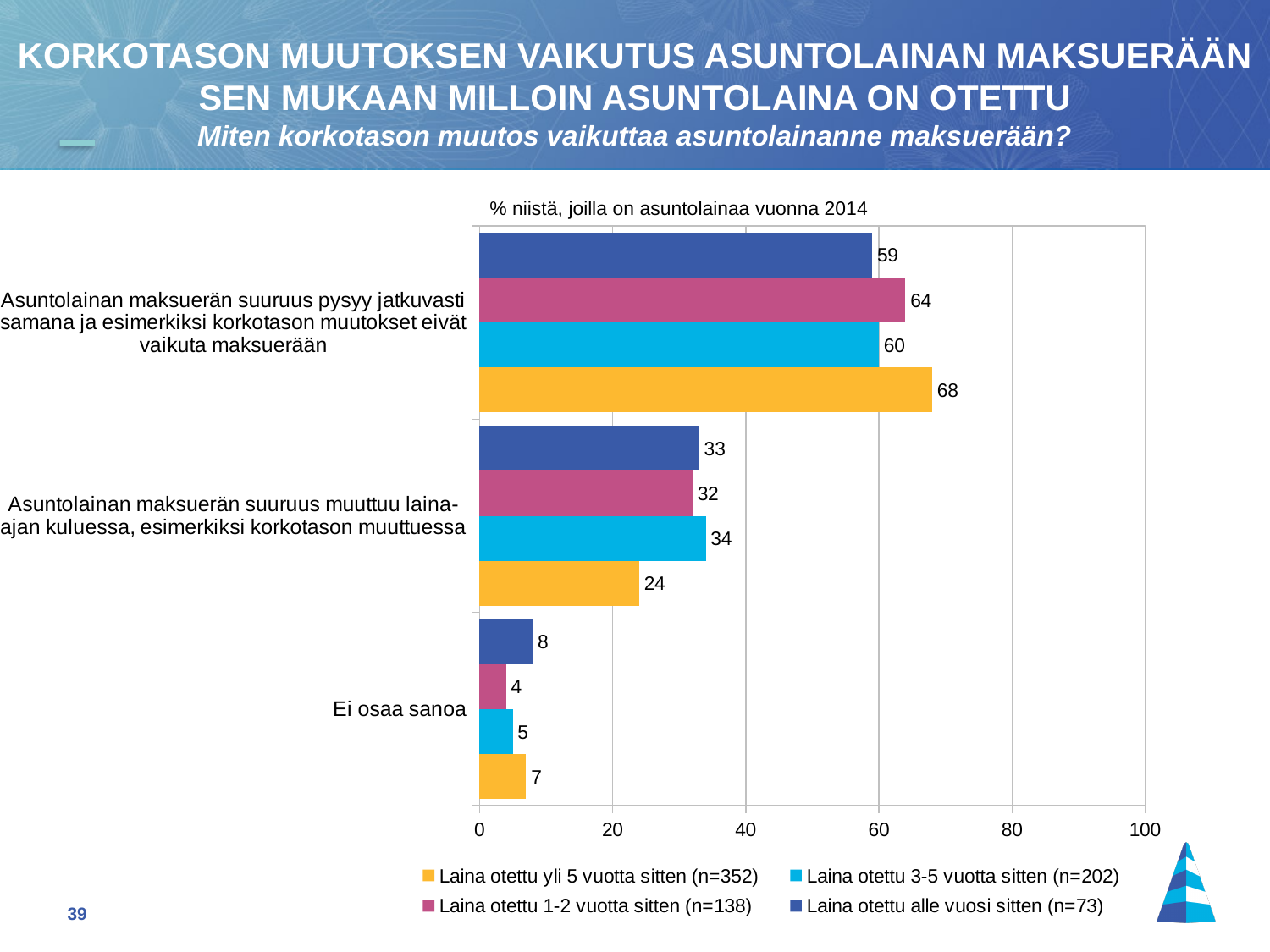
Is the value for 'Laina otettu yli 5 vuotta sitten (n=352)' in the category 'Asuntolainan maksuerän suuruus muuttuu laina-ajan kuluessa, esimerkiksi korkotason muuttuessa' greater or less than 40? less What is the value for 'Laina otettu yli 5 vuotta sitten (n=352)' in the category 'Asuntolainan maksuerän suuruus pysyy jatkuvasti samana ja esimerkiksi korkotason muutokset eivät vaikuta maksuerään'? 68 What is the value for 'Laina otettu alle vuosi sitten (n=73)' in the category 'Ei osaa sanoa'? 8 How many categories are shown on the chart? 3 In the category 'Asuntolainan maksuerän suuruus pysyy jatkuvasti samana ja esimerkiksi korkotason muutokset eivät vaikuta maksuerään', which is larger: the value for 'Laina otettu 1-2 vuotta sitten (n=138)' or for 'Laina otettu alle vuosi sitten (n=73)'? Laina otettu 1-2 vuotta sitten (n=138) Which series has the lowest value in the category 'Ei osaa sanoa'? Laina otettu 1-2 vuotta sitten (n=138) Which series has the highest value in the category 'Asuntolainan maksuerän suuruus pysyy jatkuvasti samana ja esimerkiksi korkotason muutokset eivät vaikuta maksuerään'? Laina otettu yli 5 vuotta sitten (n=352) What is the difference between the values for 'Laina otettu 3-5 vuotta sitten (n=202)' and 'Laina otettu yli 5 vuotta sitten (n=352)' in the category 'Asuntolainan maksuerän suuruus muuttuu laina-ajan kuluessa, esimerkiksi korkotason muuttuessa'? 10 What is the subtitle printed above the chart? % niistä, joilla on asuntolainaa vuonna 2014 What kind of chart is shown on the slide? bar chart How many series does the legend list? 4 What is the value for 'Laina otettu 1-2 vuotta sitten (n=138)' in the category 'Asuntolainan maksuerän suuruus muuttuu laina-ajan kuluessa, esimerkiksi korkotason muuttuessa'? 32